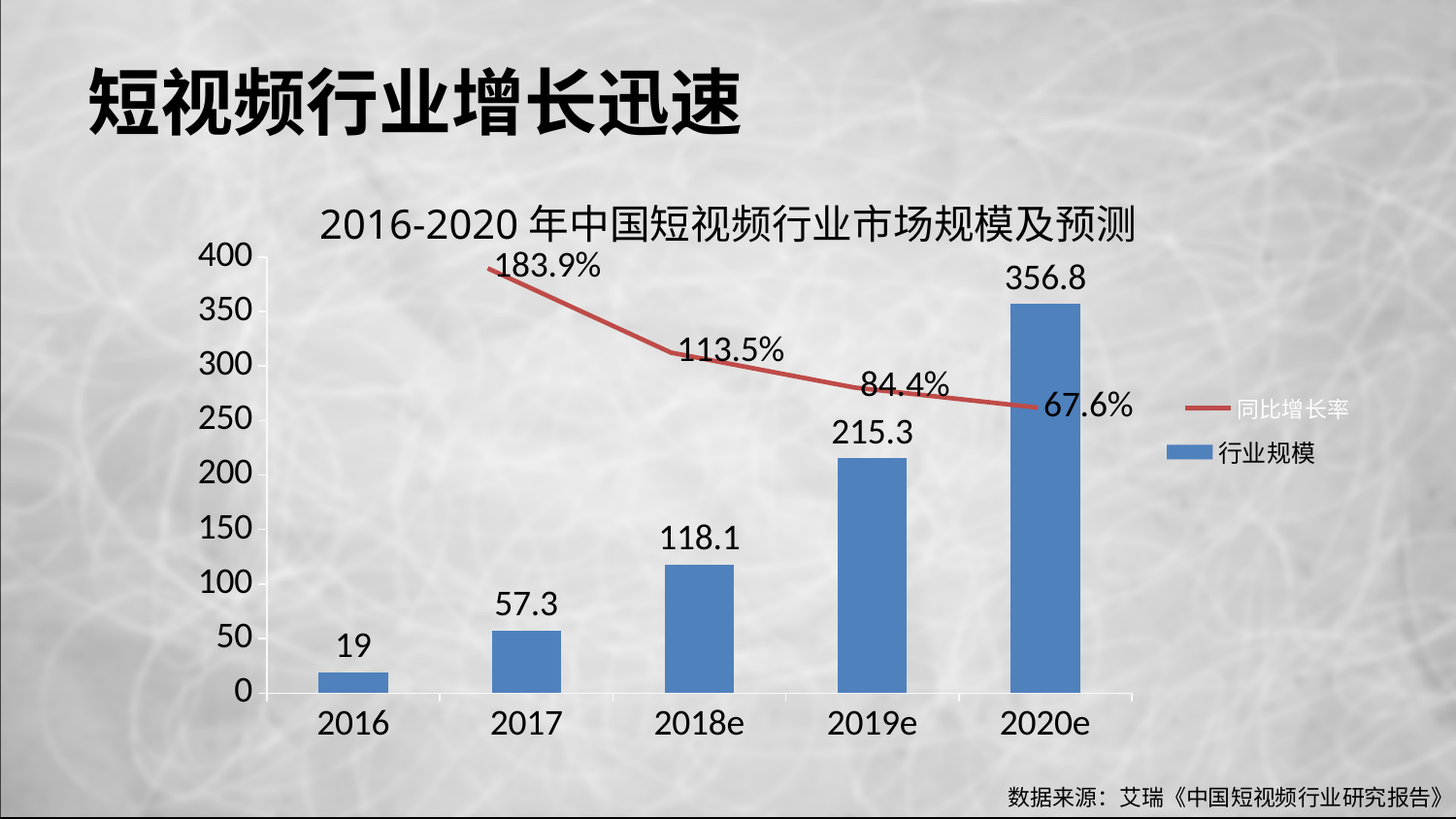
Does the 同比增长率 line rise or fall from 2017 to 2020e? fall Which is larger, the 行业规模 value for 2017 or for 2018e? 2018e What is the difference between the 行业规模 values for 2020e and 2019e? 141.5 What is the 同比增长率 value for 2020e? 67.6% Which year has the lowest 行业规模 value? 2016 What is the title of the chart? 2016-2020 年中国短视频行业市场规模及预测 How many years are shown on the x axis? 5 How many series does the legend list? 2 Which year has the highest 行业规模 value? 2020e What is the 行业规模 value for 2016? 19 What is the 同比增长率 value for 2017? 183.9% What is the 行业规模 value for 2018e? 118.1